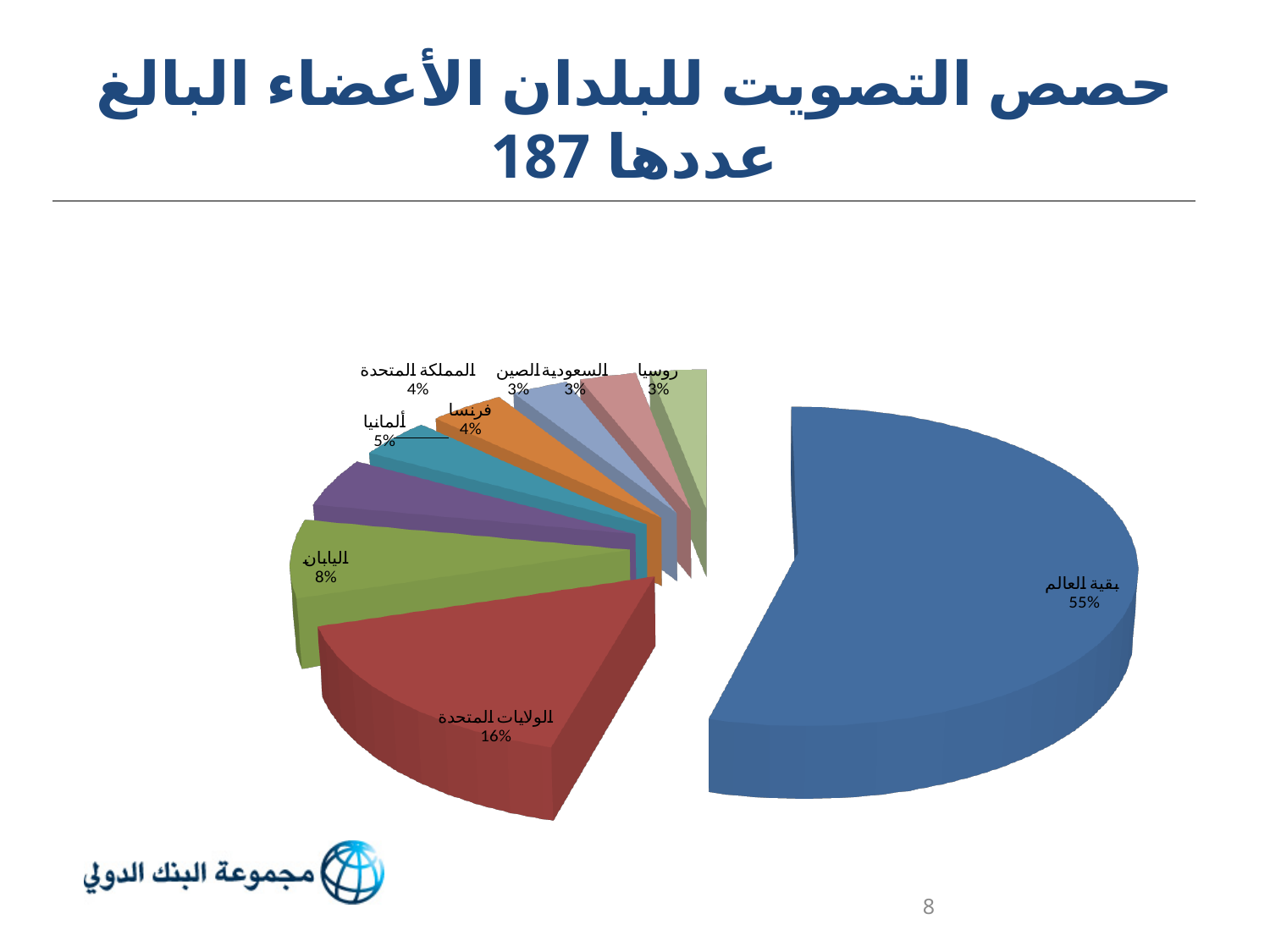
What is the voting share shown for الولايات المتحدة (United States)? 16% What type of chart is shown on the slide? pie chart What is the voting share shown for اليابان (Japan)? 8% Which slice of the pie chart is the largest? بقية العالم What is the voting share shown for ألمانيا (Germany)? 5% Which country has the largest voting share among the individually named countries? الولايات المتحدة What is the voting share shown for الصين (China)? 3% How many slices does the pie chart have? 9 Which has a larger voting share, ألمانيا or فرنسا? ألمانيا What is the difference between the voting share of الولايات المتحدة and اليابان? 8% What is the title of the chart on the slide? حصص التصويت للبلدان الأعضاء البالغ عددها 187 What is the voting share shown for بقية العالم (rest of the world)? 55%